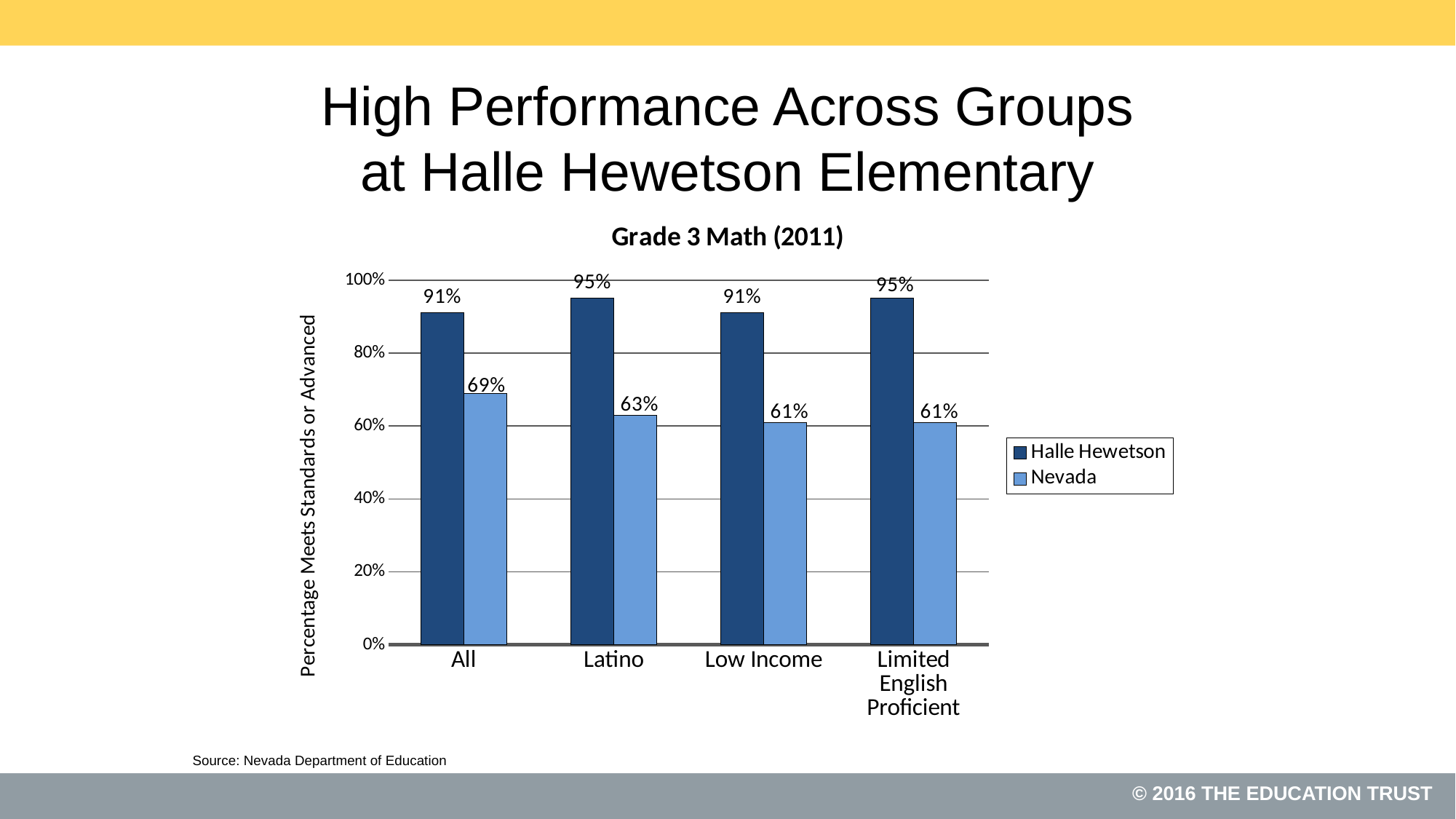
What is the difference between the Halle Hewetson and Nevada values for the All group? 22% What is the title of the chart? Grade 3 Math (2011) What is the Halle Hewetson value for the Limited English Proficient group? 95% What is the difference between the Halle Hewetson and Nevada values for the Limited English Proficient group? 34% How many groups are shown on the x axis? 4 Which is larger for the Low Income group, the Halle Hewetson value or the Nevada value? Halle Hewetson What kind of chart is shown on the slide? Bar chart Which group has the highest Nevada value? All What is the Nevada value for the Low Income group? 61% How many series does the legend list? 2 What is the Nevada value for the All group? 69% What is the Halle Hewetson value for the Latino group? 95%